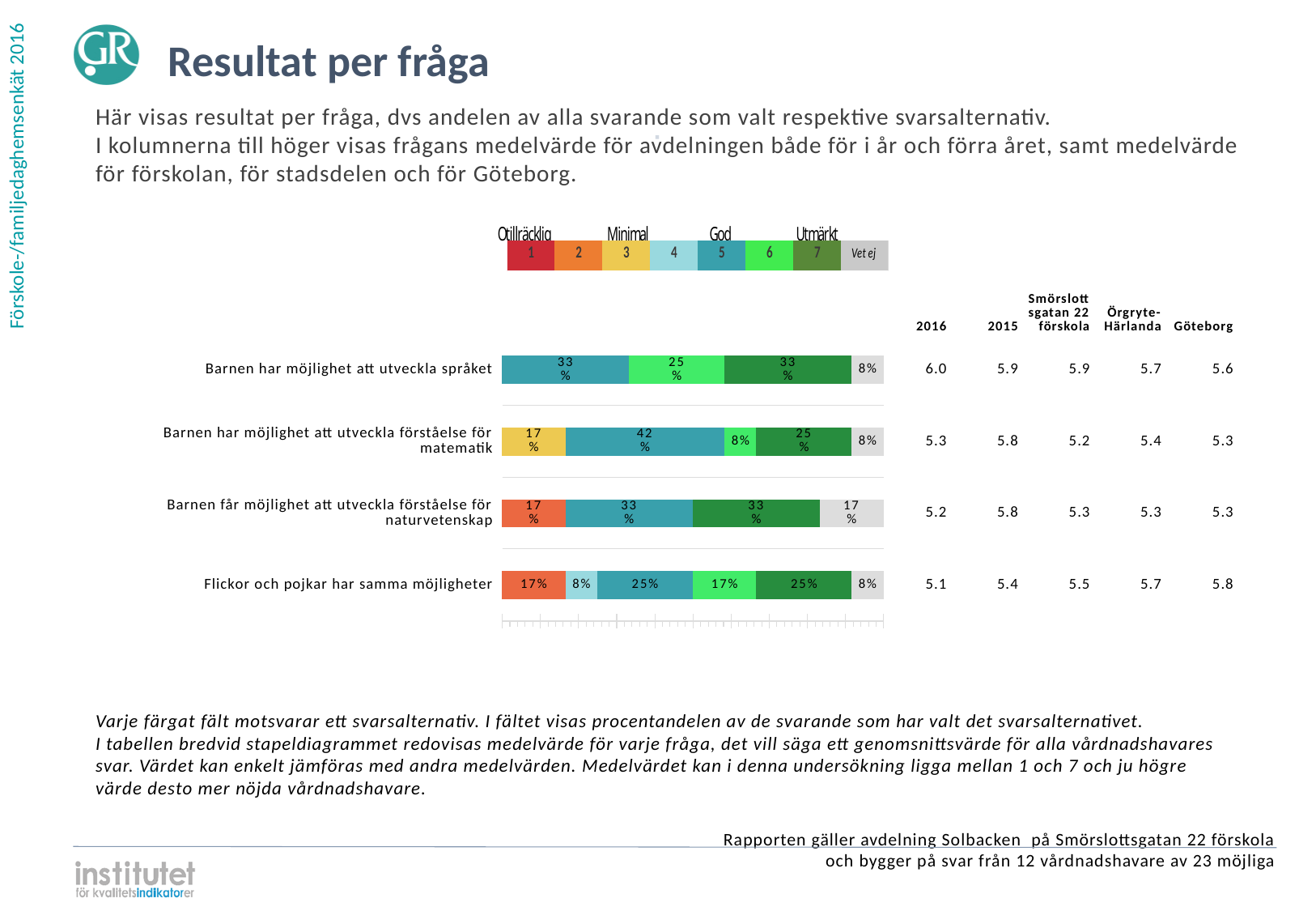
Which is larger for 'Barnen har möjlighet att utveckla förståelse för matematik': the share for answer 5 or the share for answer 7? answer 5 What is the 'Vet ej' share for 'Barnen får möjlighet att utveckla förståelse för naturvetenskap'? 17% What percentage of respondents chose answer 5 for 'Barnen har möjlighet att utveckla förståelse för matematik'? 42% Which question has the largest 'Vet ej' share? Barnen får möjlighet att utveckla förståelse för naturvetenskap What is the Göteborg mean value shown for 'Flickor och pojkar har samma möjligheter'? 5.8 What is the difference between the answer 5 share and the answer 6 share for 'Barnen har möjlighet att utveckla språket'? 8% What percentage of respondents chose answer 7 (Utmärkt) for 'Barnen har möjlighet att utveckla språket'? 33% What percentage chose answer 4 for 'Flickor och pojkar har samma möjligheter'? 8% What is the 2016 mean value shown for 'Barnen har möjlighet att utveckla språket'? 6.0 What kind of chart is shown on the slide? bar chart How many answer alternatives does the legend above the chart list? 8 How many questions (categories) are plotted in the bar chart? 4